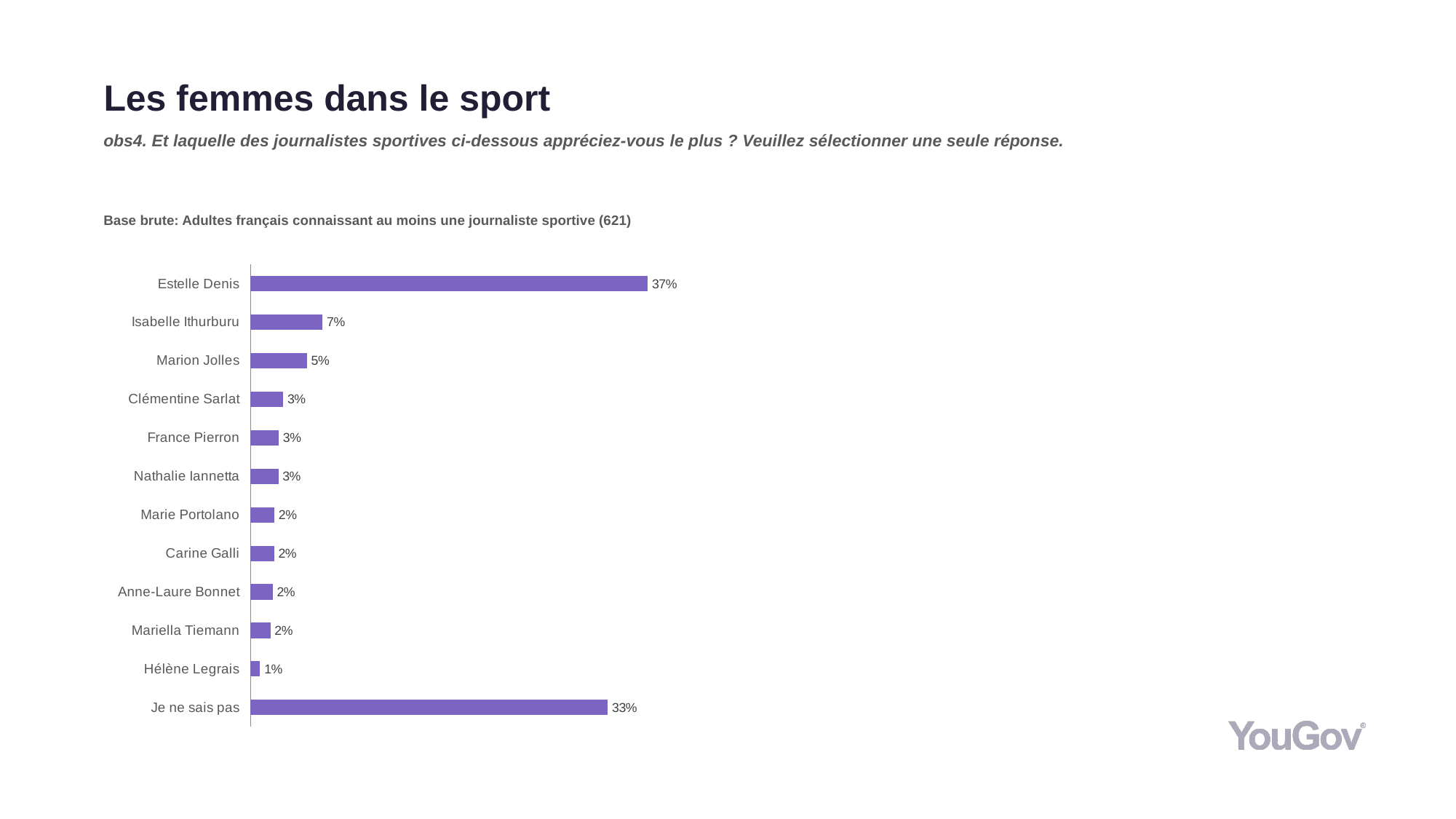
Which category has the highest value? Estelle Denis What is the value for Hélène Legrais? 1% Which category has the lowest value? Hélène Legrais What is the value for Estelle Denis? 37% What kind of chart is shown on the slide? Bar chart How many categories are shown in the chart? 12 What is the value for Je ne sais pas? 33% What is the difference between the values for Isabelle Ithurburu and Marion Jolles? 2% Which is larger, the value for Marion Jolles or the value for Clémentine Sarlat? Marion Jolles What is the value for Isabelle Ithurburu? 7% What is the difference between the values for Estelle Denis and Je ne sais pas? 4% What is the value for Marie Portolano? 2%